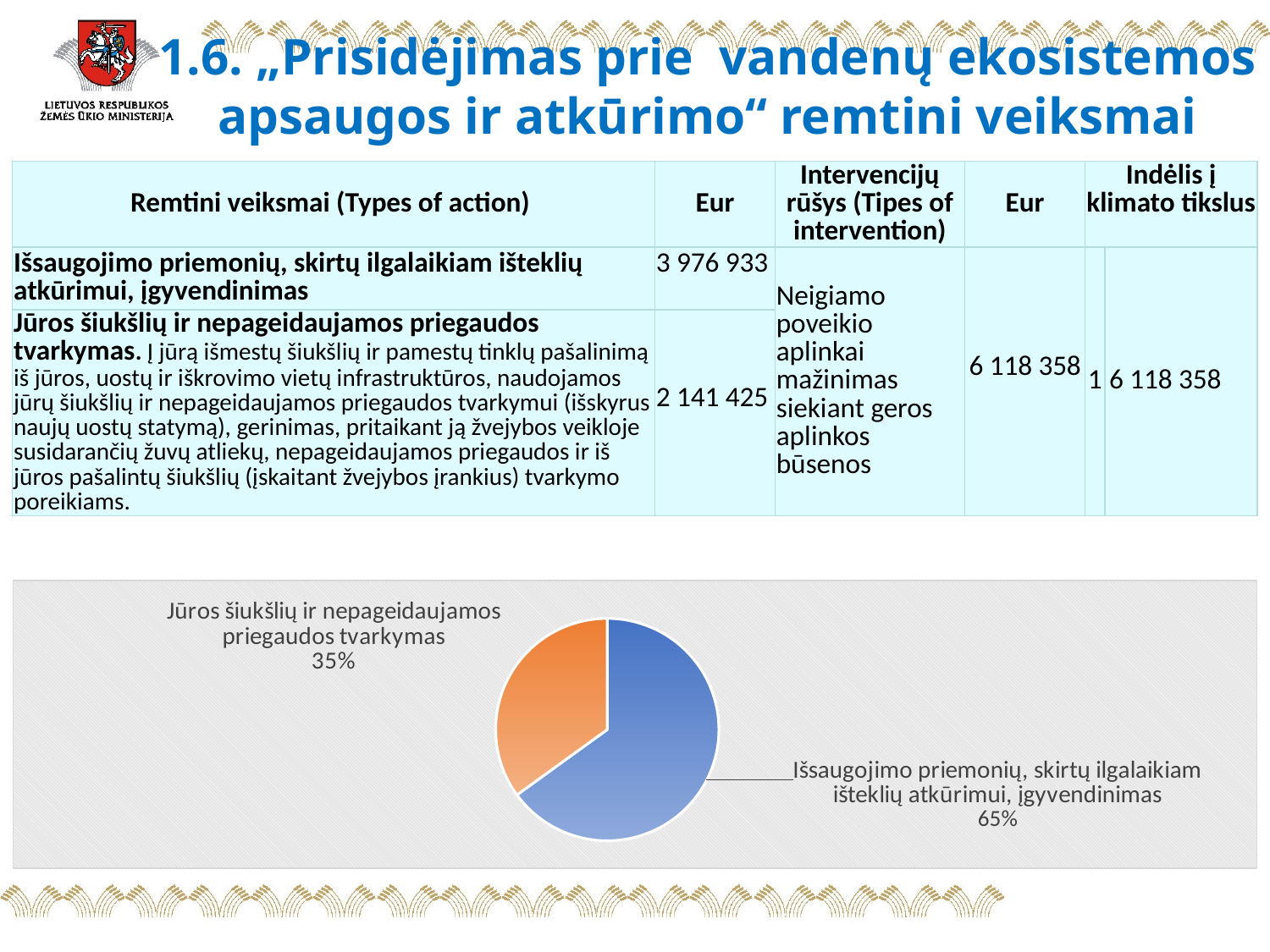
Which is larger in the pie chart: "Jūros šiukšlių ir nepageidaujamos priegaudos tvarkymas" or "Išsaugojimo priemonių, skirtų ilgalaikiam išteklių atkūrimui, įgyvendinimas"? Išsaugojimo priemonių, skirtų ilgalaikiam išteklių atkūrimui, įgyvendinimas What colour is the slice labelled 35% in the pie chart? orange Which slice of the pie chart is the smallest? Jūros šiukšlių ir nepageidaujamos priegaudos tvarkymas What share of the pie does "Jūros šiukšlių ir nepageidaujamos priegaudos tvarkymas" represent? 35% What is the difference in percentage points between the two slices of the pie chart? 30 What colour is the slice labelled 65% in the pie chart? blue Which slice of the pie chart is the largest? Išsaugojimo priemonių, skirtų ilgalaikiam išteklių atkūrimui, įgyvendinimas What is the total of the two percentages shown on the pie chart? 100% What kind of chart is shown on the slide? pie chart What share of the pie does "Išsaugojimo priemonių, skirtų ilgalaikiam išteklių atkūrimui, įgyvendinimas" represent? 65% How many slices does the pie chart have? 2